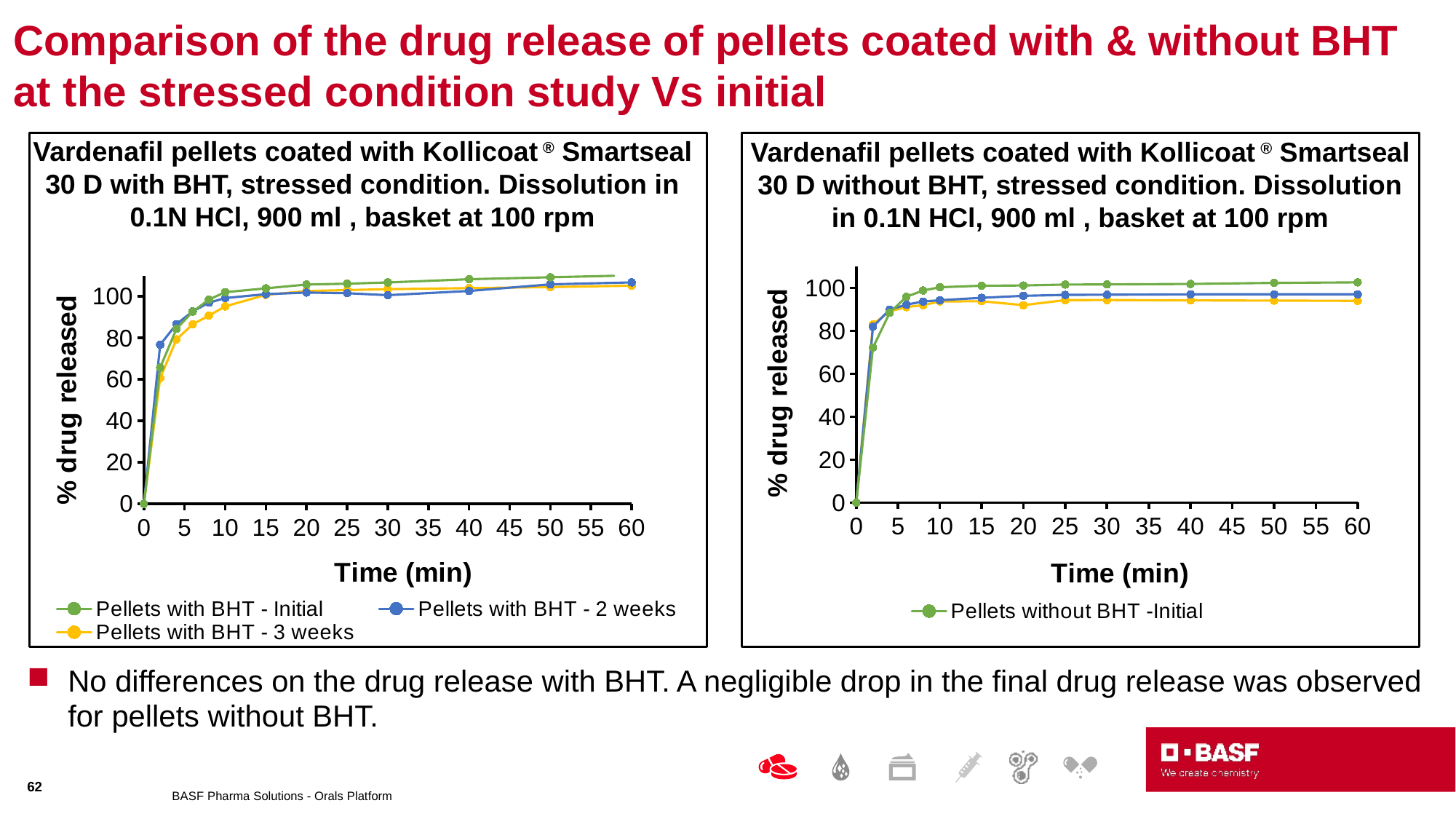
In the left chart (pellets with BHT), is the value for 'Pellets with BHT - 2 weeks' at 2 min greater or less than 60? greater In the right chart (pellets without BHT), is the value for 'Pellets without BHT -Initial' at 2 min greater or less than 60? greater How many series does the legend of the right chart (pellets without BHT) list? 1 In the left chart (pellets with BHT), is the value for 'Pellets with BHT - Initial' at 2 min greater or less than 40? greater How many series does the legend of the left chart (pellets with BHT) list? 3 What is the x-axis title of the left chart (pellets with BHT)? Time (min) What kind of chart is the left chart, 'Vardenafil pellets coated with Kollicoat Smartseal 30 D with BHT'? line chart In the left chart (pellets with BHT), at 2 min, which is larger: 'Pellets with BHT - 2 weeks' or 'Pellets with BHT - 3 weeks'? Pellets with BHT - 2 weeks What is the y-axis title of the right chart (pellets without BHT)? % drug released In the right chart (pellets without BHT), do the values for 'Pellets without BHT -Initial' rise or fall as time increases from 0 to 60 min? rise